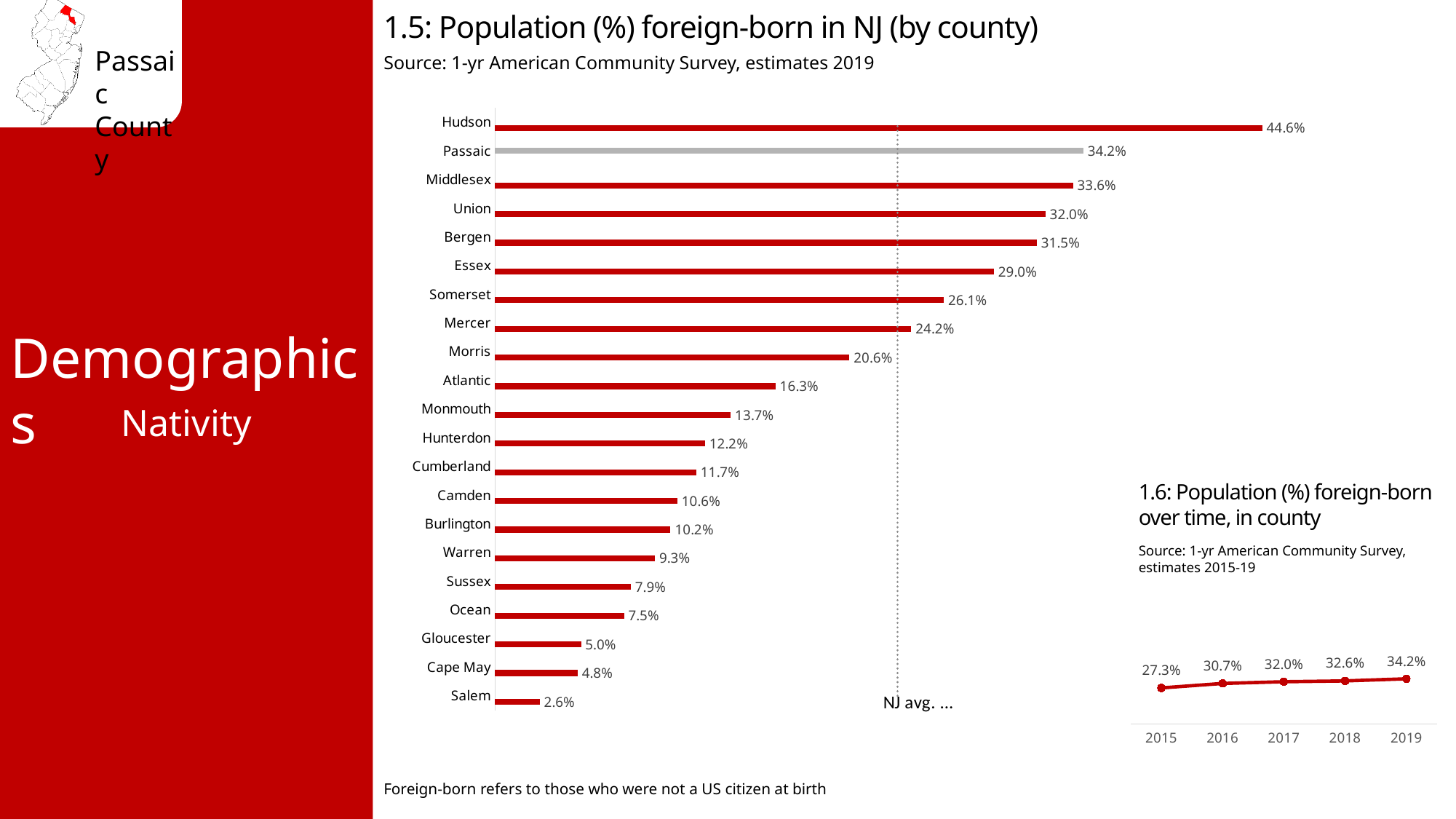
In chart 1.5 (Population (%) foreign-born in NJ by county), which county has the lowest value? Salem In chart 1.6 (Population (%) foreign-born over time, in county), do the values rise or fall from 2015 to 2019? Rise In chart 1.6 (Population (%) foreign-born over time, in county), what is the difference between 2019 and 2015? 6.9% In chart 1.5 (Population (%) foreign-born in NJ by county), what is the difference between Hudson and Passaic? 10.4% In chart 1.6 (Population (%) foreign-born over time, in county), what is the value for 2017? 32.0% In chart 1.5 (Population (%) foreign-born in NJ by county), which is larger, Essex or Somerset? Essex In chart 1.5 (Population (%) foreign-born in NJ by county), how many counties are shown? 21 In chart 1.5 (Population (%) foreign-born in NJ by county), which county's bar is coloured grey instead of red? Passaic In chart 1.5 (Population (%) foreign-born in NJ by county), what is the value for Passaic? 34.2% In chart 1.5 (Population (%) foreign-born in NJ by county), which county has the highest value? Hudson What kind of chart is chart 1.5 (Population (%) foreign-born in NJ by county)? Bar chart In chart 1.5 (Population (%) foreign-born in NJ by county), what is the value for Bergen? 31.5%